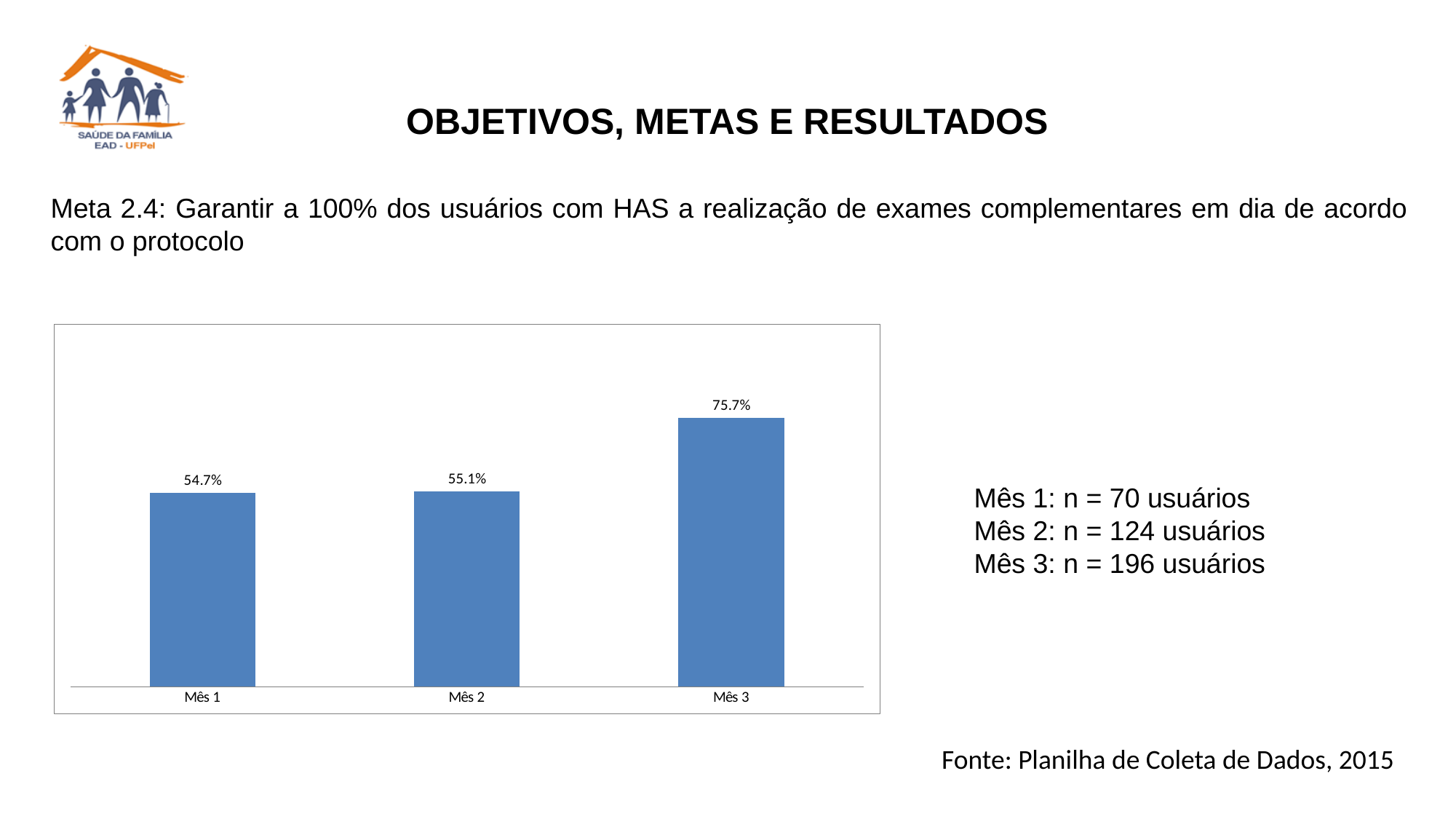
How many categories are shown on the x axis? 3 What is the value for Mês 3? 75.7% Which month has the highest value? Mês 3 Which is larger, the value for Mês 3 or the value for Mês 2? Mês 3 Which month has the lowest value? Mês 1 What colour are the bars in the chart? Blue What is the difference between the values for Mês 3 and Mês 1? 21.0% Do the values rise or fall from Mês 1 to Mês 3? Rise What kind of chart is shown on the slide? Bar chart What is the value for Mês 2? 55.1% What is the difference between the values for Mês 3 and Mês 2? 20.6% What is the value for Mês 1? 54.7%